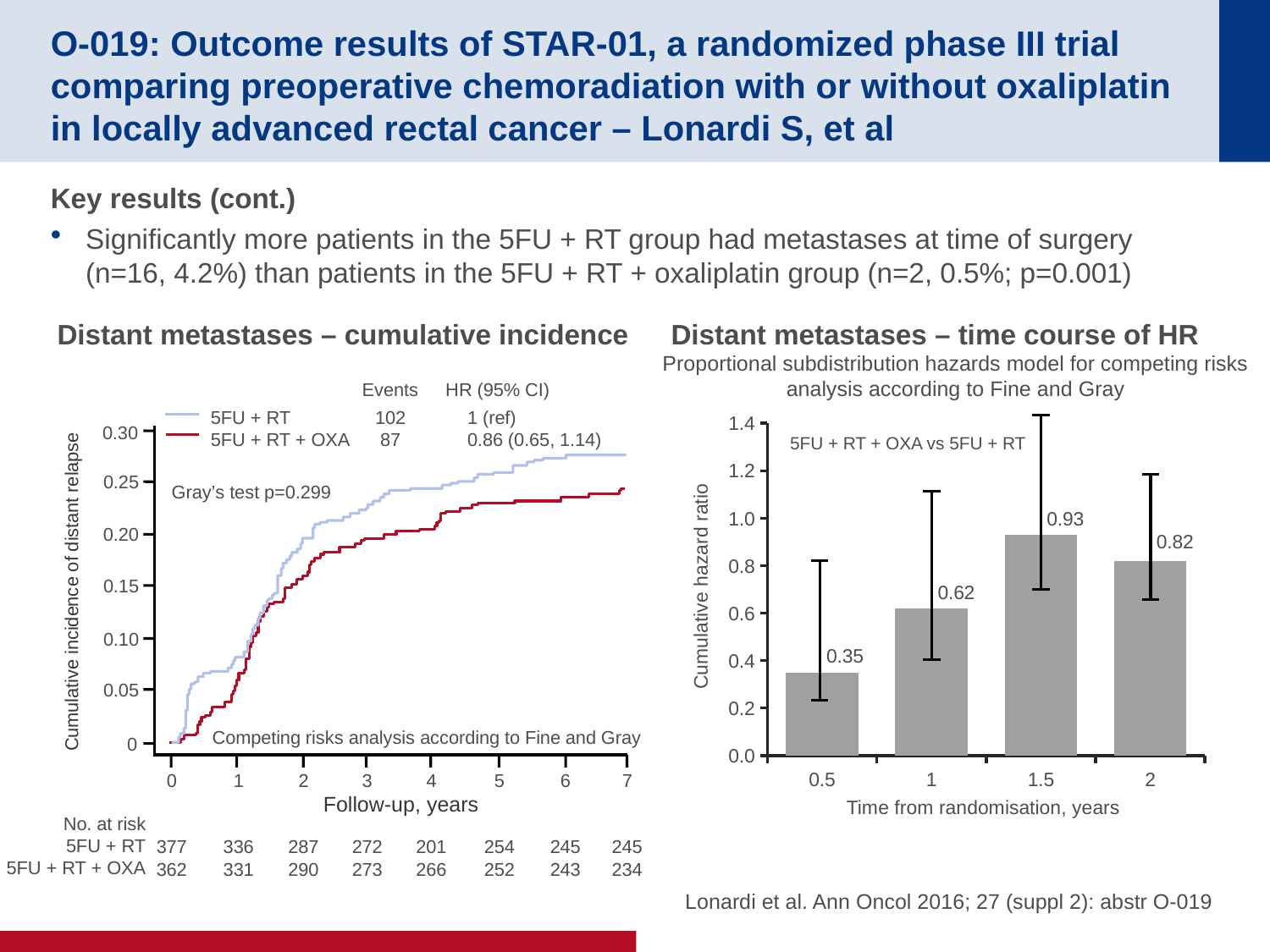
In the 'Distant metastases – time course of HR' chart, what is the cumulative hazard ratio at 0.5 years? 0.35 In the 'Distant metastases – cumulative incidence' chart, how many events are listed for the 5FU + RT + OXA group? 87 What kind of chart is the 'Distant metastases – time course of HR' chart? Bar chart In the 'Distant metastases – time course of HR' chart, at which time point is the cumulative hazard ratio highest? 1.5 In the 'Distant metastases – cumulative incidence' chart, is the cumulative incidence for 5FU + RT at 7 years greater or less than 0.25? greater In the 'Distant metastases – cumulative incidence' chart, what is the Gray's test p-value shown? p=0.299 In the 'Distant metastases – time course of HR' chart, what is the cumulative hazard ratio at 1.5 years from randomisation? 0.93 In the 'Distant metastases – time course of HR' chart, what is the difference between the hazard ratio at 1.5 years and at 0.5 years? 0.58 In the 'Distant metastases – time course of HR' chart, is the hazard ratio at 1 year or at 2 years larger? 2 years In the 'Distant metastases – cumulative incidence' chart, how many series does the legend list? 2 In the 'Distant metastases – time course of HR' chart, at which time point is the cumulative hazard ratio lowest? 0.5 In the 'Distant metastases – time course of HR' chart, how many time points are plotted? 4